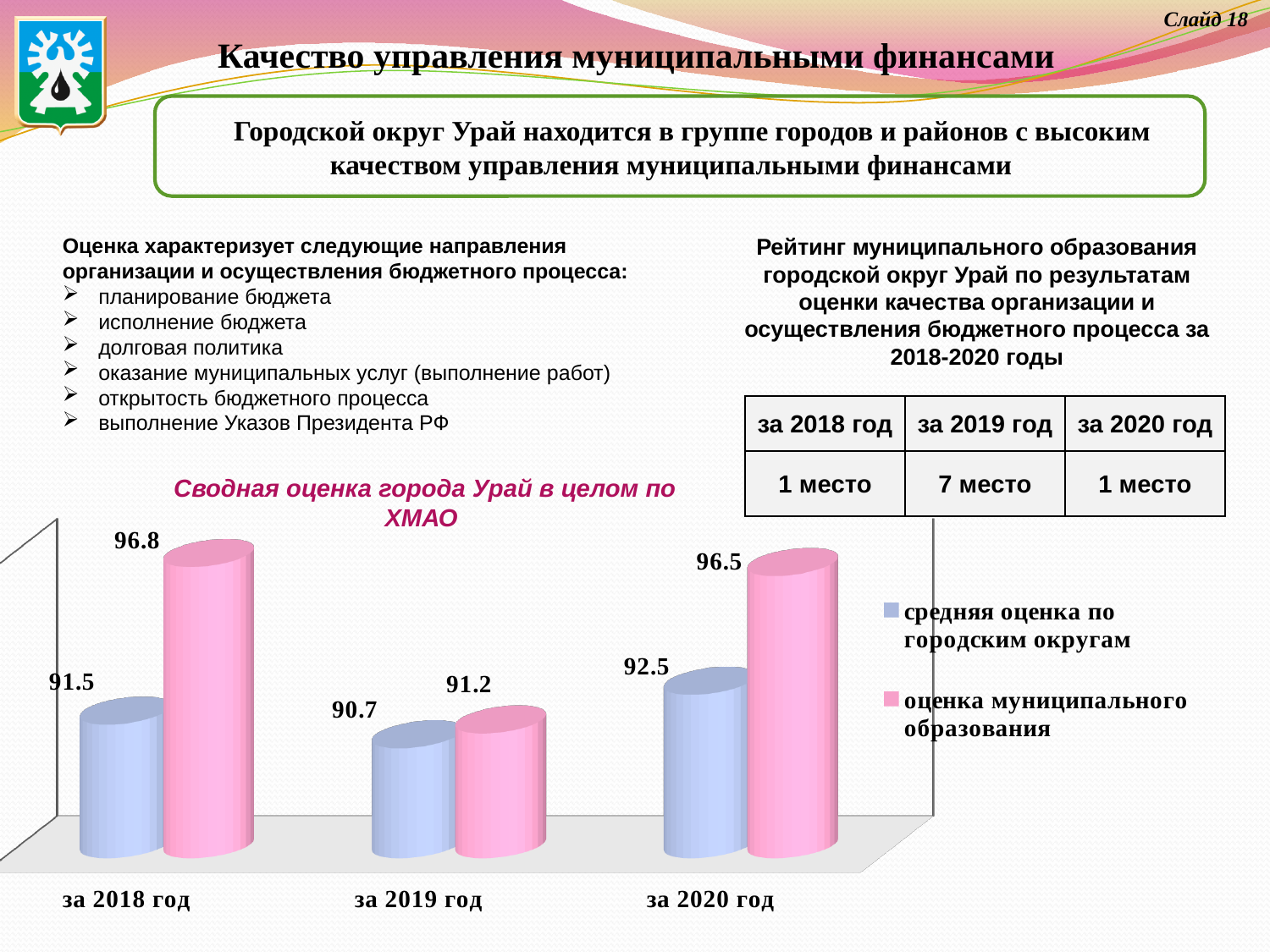
Что больше за 2019 год: «средняя оценка по городским округам» или «оценка муниципального образования»? оценка муниципального образования Какое значение имеет «оценка муниципального образования» за 2018 год на диаграмме «Сводная оценка города Урай в целом по ХМАО»? 96.8 Какое значение имеет «оценка муниципального образования» за 2020 год? 96.5 Сколько рядов данных указано в легенде диаграммы? 2 На сколько «оценка муниципального образования» за 2020 год превышает «среднюю оценку по городским округам» за 2020 год? 4 В каком году «оценка муниципального образования» была самой низкой? за 2019 год Сколько категорий (лет) показано на диаграмме? 3 Какое значение имеет «средняя оценка по городским округам» за 2019 год? 90.7 Какое значение имеет «средняя оценка по городским округам» за 2020 год? 92.5 На сколько «оценка муниципального образования» за 2018 год превышает «среднюю оценку по городским округам» за 2018 год? 5.3 Какого типа диаграмма на слайде? столбчатая (bar chart) В каком году «оценка муниципального образования» была самой высокой? за 2018 год